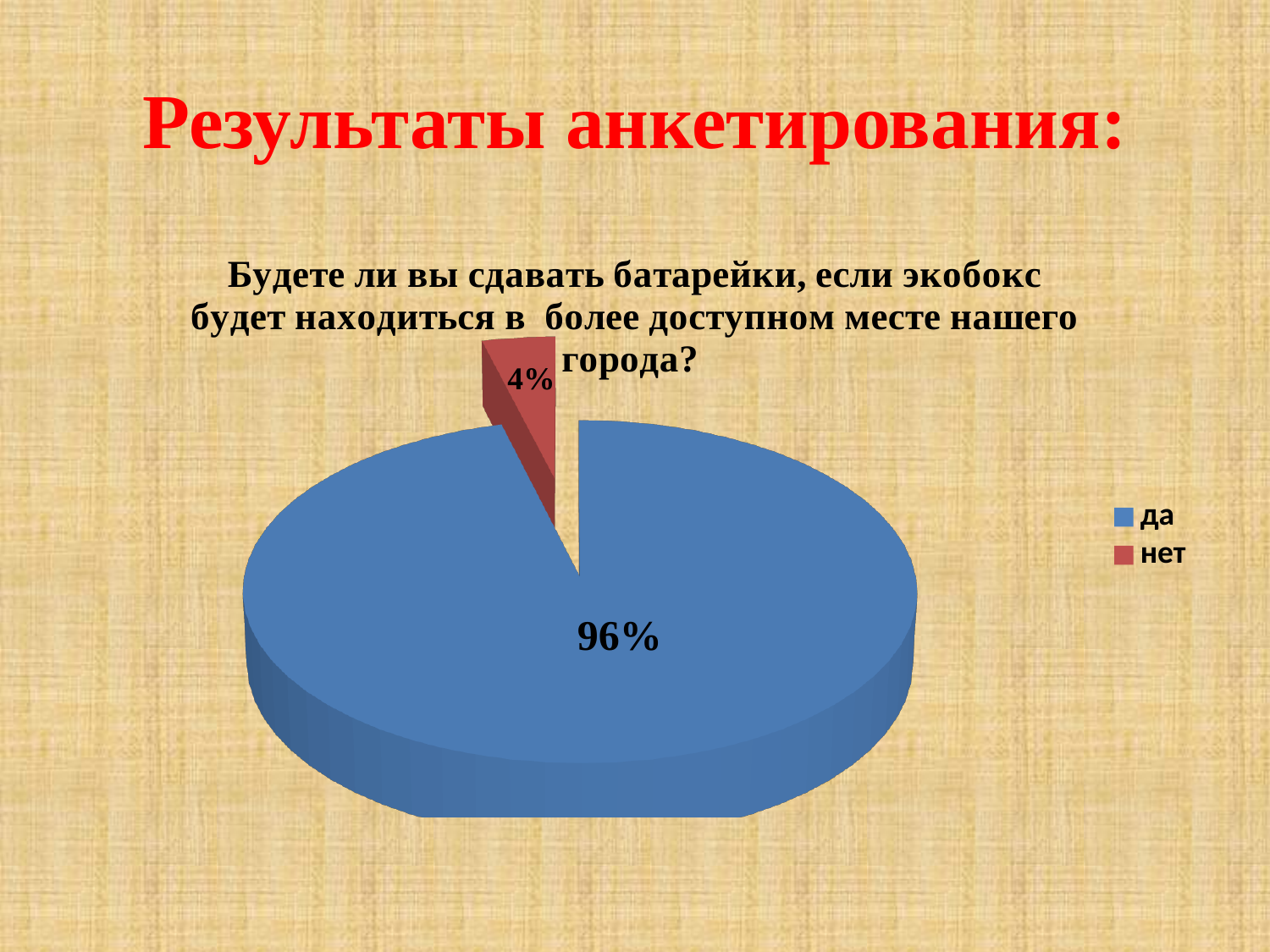
What share of the pie does the "нет" slice represent? 4% What is the difference in percentage points between the "да" and "нет" slices? 92 Which answer has the smallest share of the pie? нет What colour is the "да" slice? blue Which slice is larger, "да" or "нет"? да How many slices does the pie chart have? 2 What colour is the "нет" slice? red What percentage of respondents answered "нет"? 4% Which answer has the largest share of the pie? да What percentage of respondents answered "да"? 96% What kind of chart is shown on the slide? pie chart How many entries does the legend list? 2